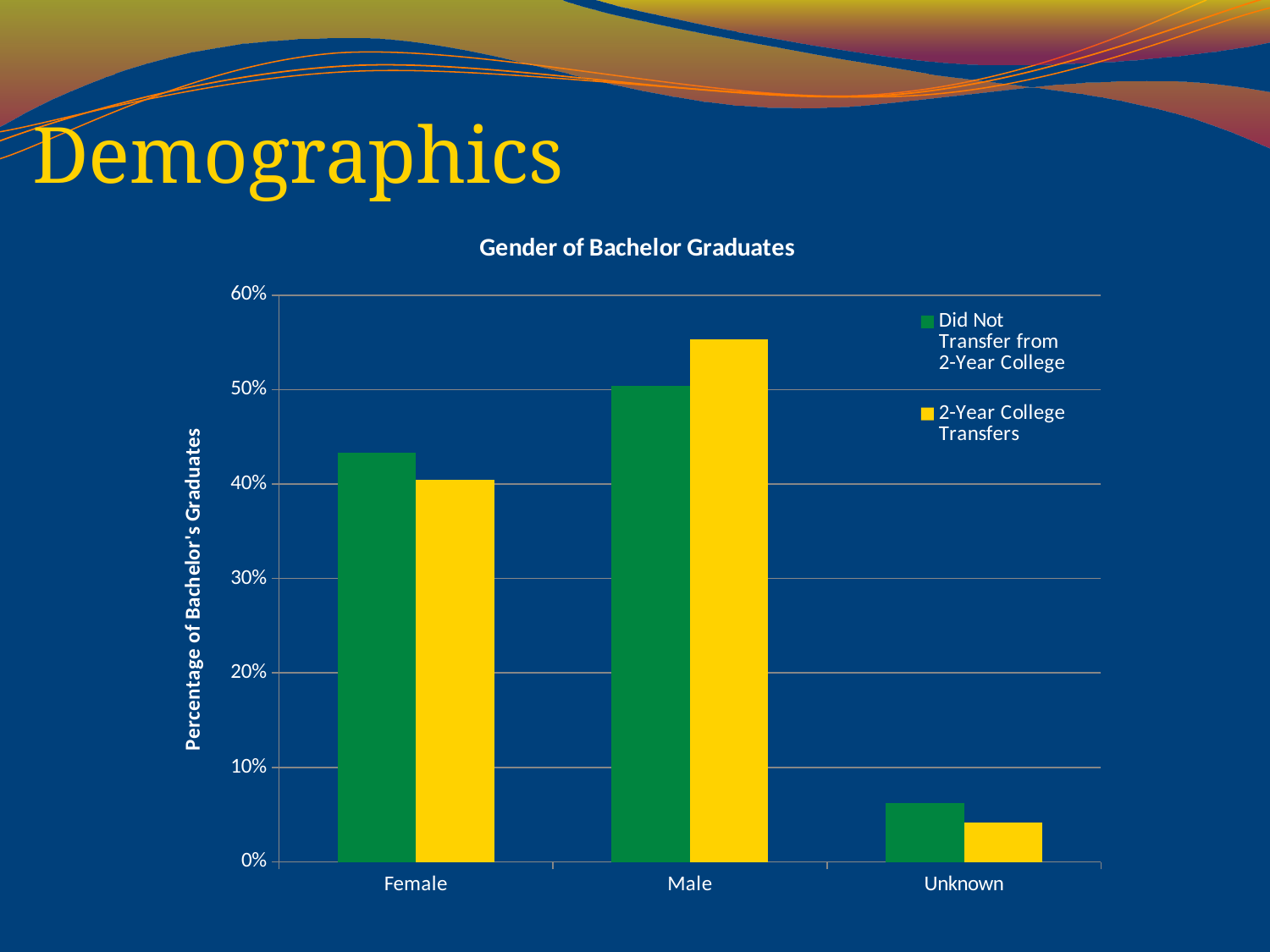
How many categories are shown on the x axis? 3 For the Male category, which series has the larger value: Did Not Transfer from 2-Year College or 2-Year College Transfers? 2-Year College Transfers How many series does the legend list? 2 What is the title of the chart? Gender of Bachelor Graduates Which category has the highest value for the 2-Year College Transfers series? Male What is the label of the y axis? Percentage of Bachelor's Graduates What kind of chart is shown on the slide? bar chart Is the value for Male in the 2-Year College Transfers series greater or less than 50%? greater For the Female category, which series has the larger value: Did Not Transfer from 2-Year College or 2-Year College Transfers? Did Not Transfer from 2-Year College Is the value for Female in the Did Not Transfer from 2-Year College series greater or less than 40%? greater Which category has the lowest value for the Did Not Transfer from 2-Year College series? Unknown Is the value for Unknown in the Did Not Transfer from 2-Year College series greater or less than 10%? less